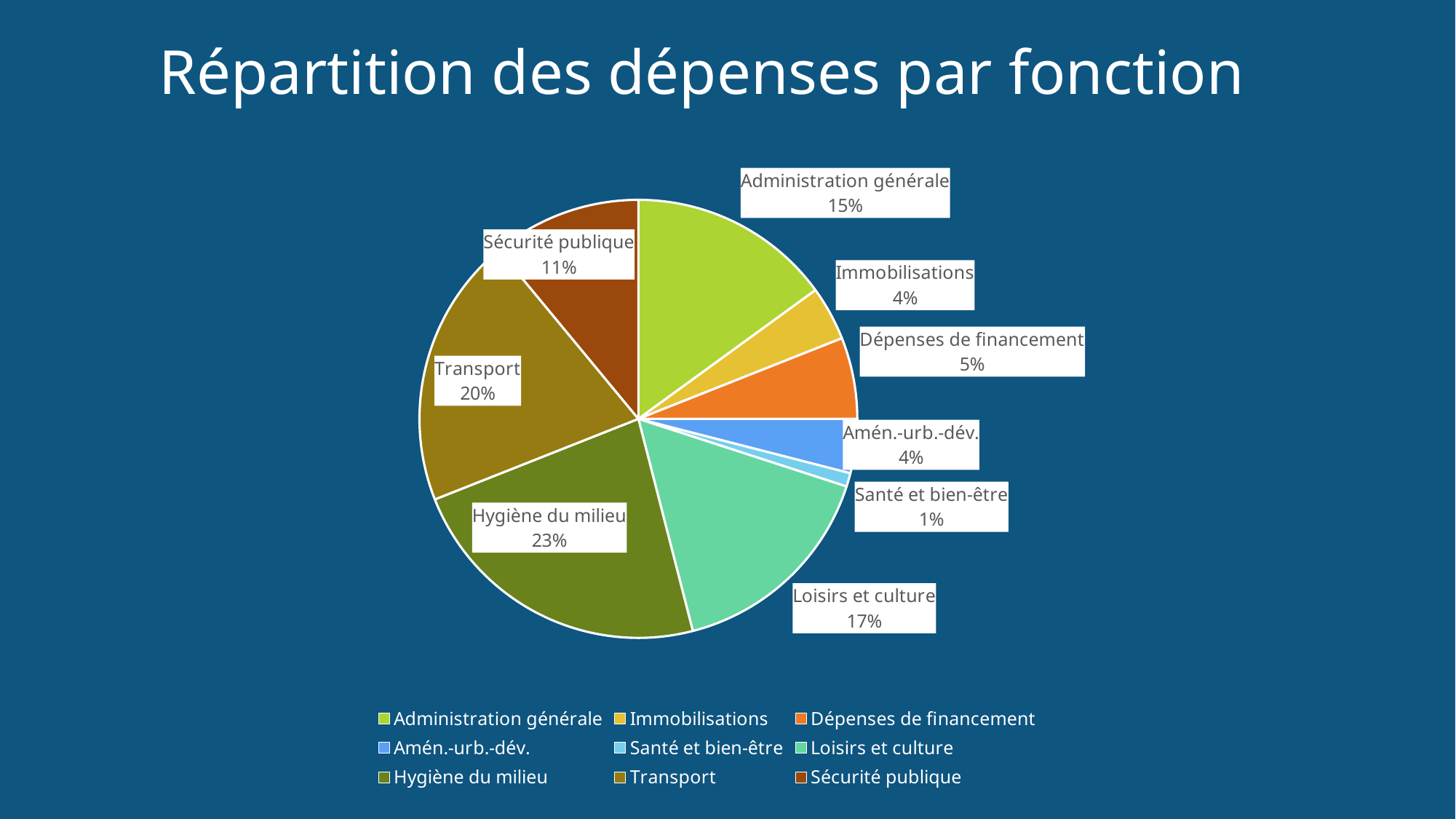
How many categories are shown in the pie chart? 9 What kind of chart is shown on the slide? Pie chart Which category has the smallest slice of the pie? Santé et bien-être What is the value shown for Loisirs et culture? 17% What is the value shown for Dépenses de financement? 5% What is the value shown for Transport? 20% What is the difference between the shares of Transport and Sécurité publique? 9% What is the combined share of Immobilisations and Amén.-urb.-dév.? 8% Which category has the largest slice of the pie? Hygiène du milieu What share of the pie does Hygiène du milieu represent? 23% Which is larger, Administration générale or Loisirs et culture? Loisirs et culture What is the title of the chart? Répartition des dépenses par fonction